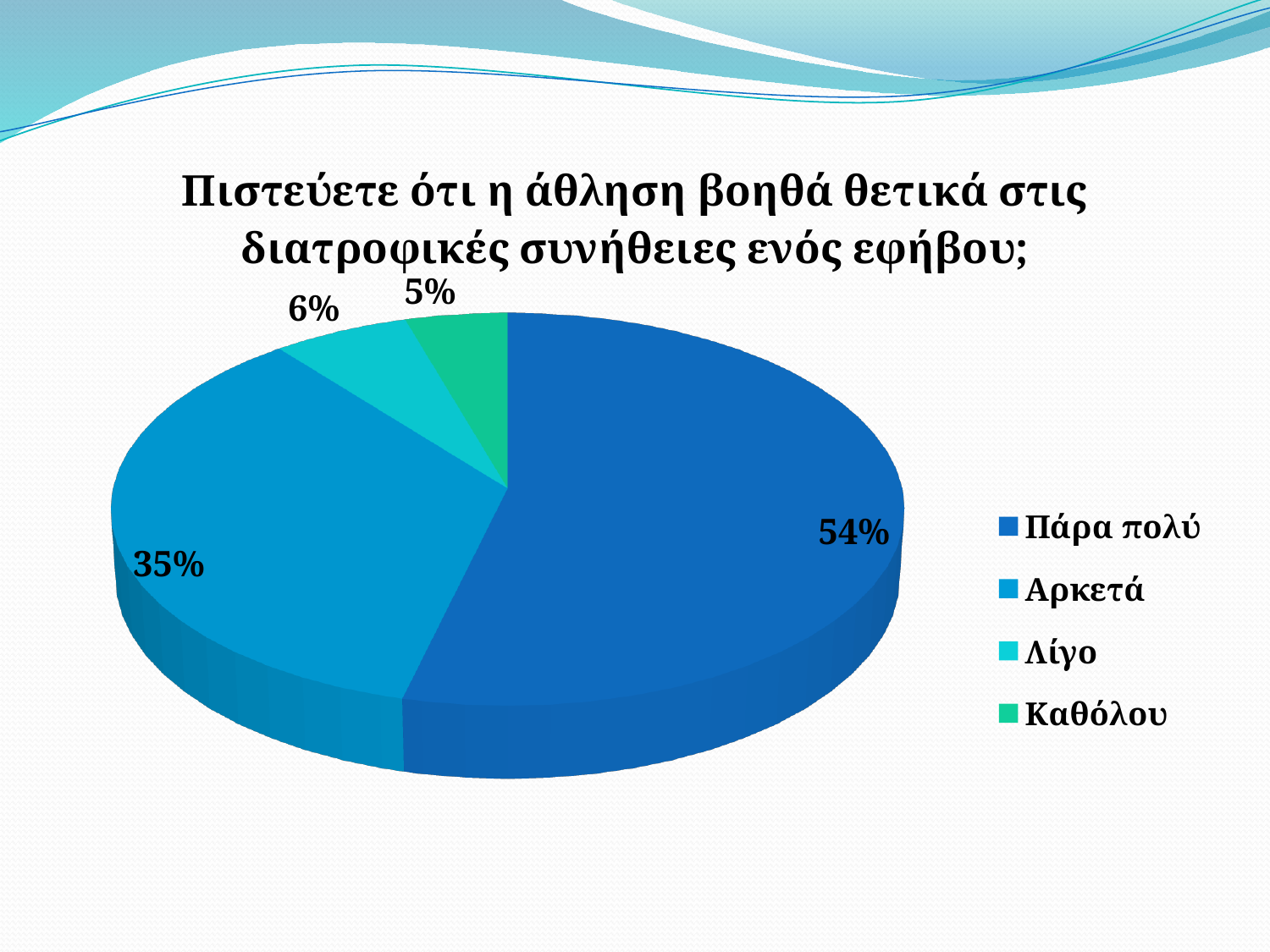
Which category has the largest slice of the pie? Πάρα πολύ What percentage of the pie corresponds to "Λίγο"? 6% What is the combined share of "Λίγο" and "Καθόλου"? 11% Which category has the smallest slice of the pie? Καθόλου What is the difference in percentage points between "Πάρα πολύ" and "Αρκετά"? 19 What percentage of the pie corresponds to "Πάρα πολύ"? 54% What is the title of the chart? Πιστεύετε ότι η άθληση βοηθά θετικά στις διατροφικές συνήθειες ενός εφήβου; How many categories does the pie chart have? 4 Which is larger, the slice for "Αρκετά" or the slice for "Λίγο"? Αρκετά What type of chart is shown on the slide? pie chart What percentage of the pie corresponds to "Αρκετά"? 35% What percentage of the pie corresponds to "Καθόλου"? 5%